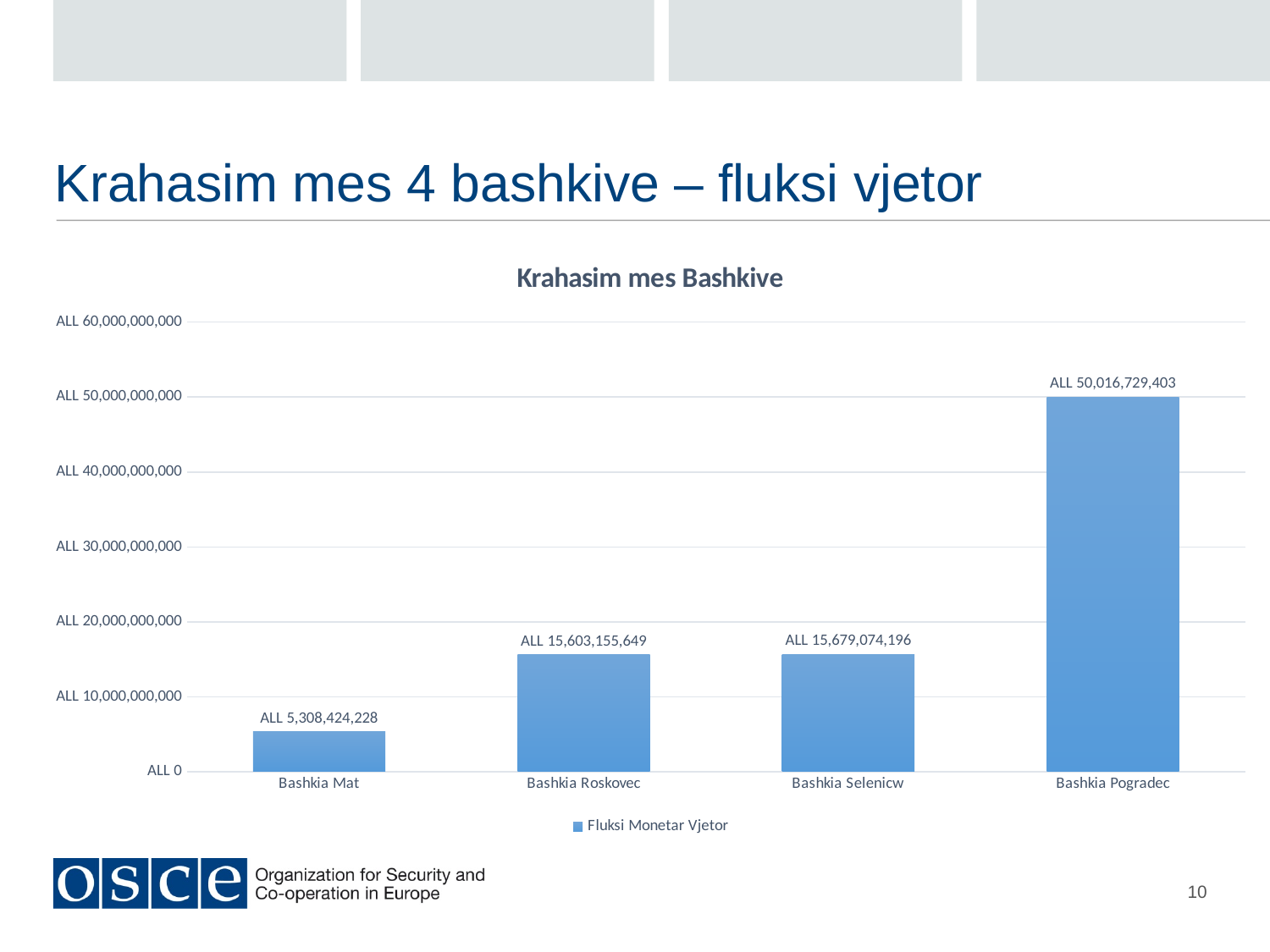
Which municipality has the lowest value? Bashkia Mat Which municipality has the highest value? Bashkia Pogradec What is the value for Bashkia Pogradec? ALL 50,016,729,403 What kind of chart is shown on the slide? bar chart Is the value for Bashkia Mat greater or less than ALL 10,000,000,000? less What series name does the legend show? Fluksi Monetar Vjetor What is the value for Bashkia Mat? ALL 5,308,424,228 What is the value for Bashkia Roskovec? ALL 15,603,155,649 Which is larger, the value for Bashkia Pogradec or the value for Bashkia Roskovec? Bashkia Pogradec What is the difference between the values for Bashkia Pogradec and Bashkia Mat? ALL 44,708,305,175 What is the value for Bashkia Selenicw? ALL 15,679,074,196 How many municipalities are shown on the chart? 4